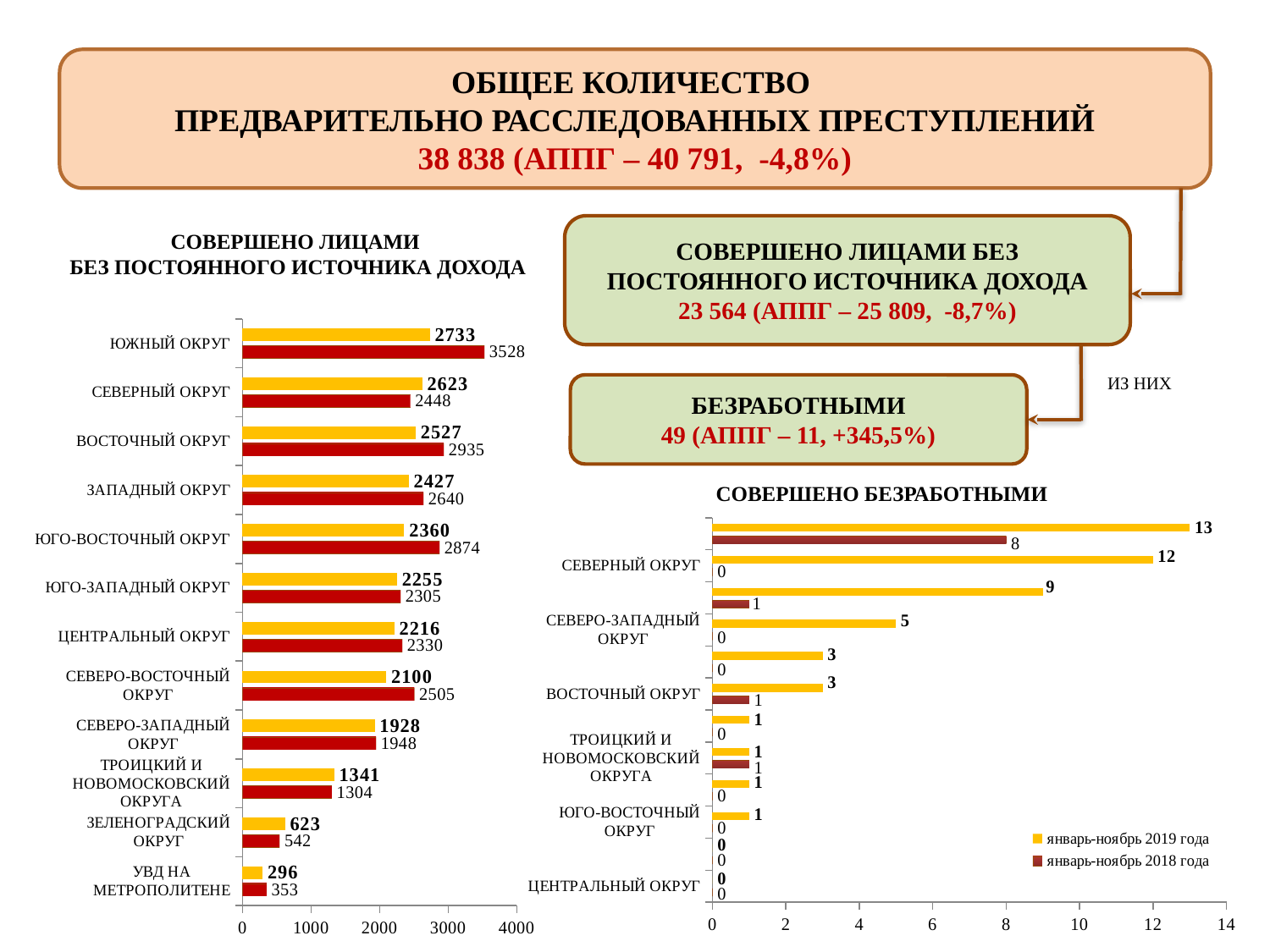
On the chart 'СОВЕРШЕНО ЛИЦАМИ БЕЗ ПОСТОЯННОГО ИСТОЧНИКА ДОХОДА', which category has the lowest 2018 (red) value? УВД НА МЕТРОПОЛИТЕНЕ On the chart 'СОВЕРШЕНО ЛИЦАМИ БЕЗ ПОСТОЯННОГО ИСТОЧНИКА ДОХОДА', which is larger for СЕВЕРНЫЙ ОКРУГ: the 2019 value or the 2018 value? 2019 value (2623) On the chart 'СОВЕРШЕНО ЛИЦАМИ БЕЗ ПОСТОЯННОГО ИСТОЧНИКА ДОХОДА', which district has the highest 2019 (yellow) value? ЮЖНЫЙ ОКРУГ On the chart 'СОВЕРШЕНО БЕЗРАБОТНЫМИ', what is the largest value shown on any bar? 13 How many categories are shown on the chart 'СОВЕРШЕНО ЛИЦАМИ БЕЗ ПОСТОЯННОГО ИСТОЧНИКА ДОХОДА'? 12 On the chart 'СОВЕРШЕНО ЛИЦАМИ БЕЗ ПОСТОЯННОГО ИСТОЧНИКА ДОХОДА', what is the 2018 (red) value for ВОСТОЧНЫЙ ОКРУГ? 2935 On the chart 'СОВЕРШЕНО ЛИЦАМИ БЕЗ ПОСТОЯННОГО ИСТОЧНИКА ДОХОДА', what is the difference between the 2018 and 2019 values for ЮЖНЫЙ ОКРУГ? 795 On the chart 'СОВЕРШЕНО ЛИЦАМИ БЕЗ ПОСТОЯННОГО ИСТОЧНИКА ДОХОДА', what is the 2019 (yellow) value for ЮЖНЫЙ ОКРУГ? 2733 What are the two legend entries on the chart 'СОВЕРШЕНО БЕЗРАБОТНЫМИ'? январь-ноябрь 2019 года; январь-ноябрь 2018 года What type of chart is 'СОВЕРШЕНО ЛИЦАМИ БЕЗ ПОСТОЯННОГО ИСТОЧНИКА ДОХОДА'? Bar chart On the chart 'СОВЕРШЕНО ЛИЦАМИ БЕЗ ПОСТОЯННОГО ИСТОЧНИКА ДОХОДА', is the 2019 value for ЗЕЛЕНОГРАДСКИЙ ОКРУГ greater or less than 1000? less How many series does the legend of the chart 'СОВЕРШЕНО БЕЗРАБОТНЫМИ' list? 2